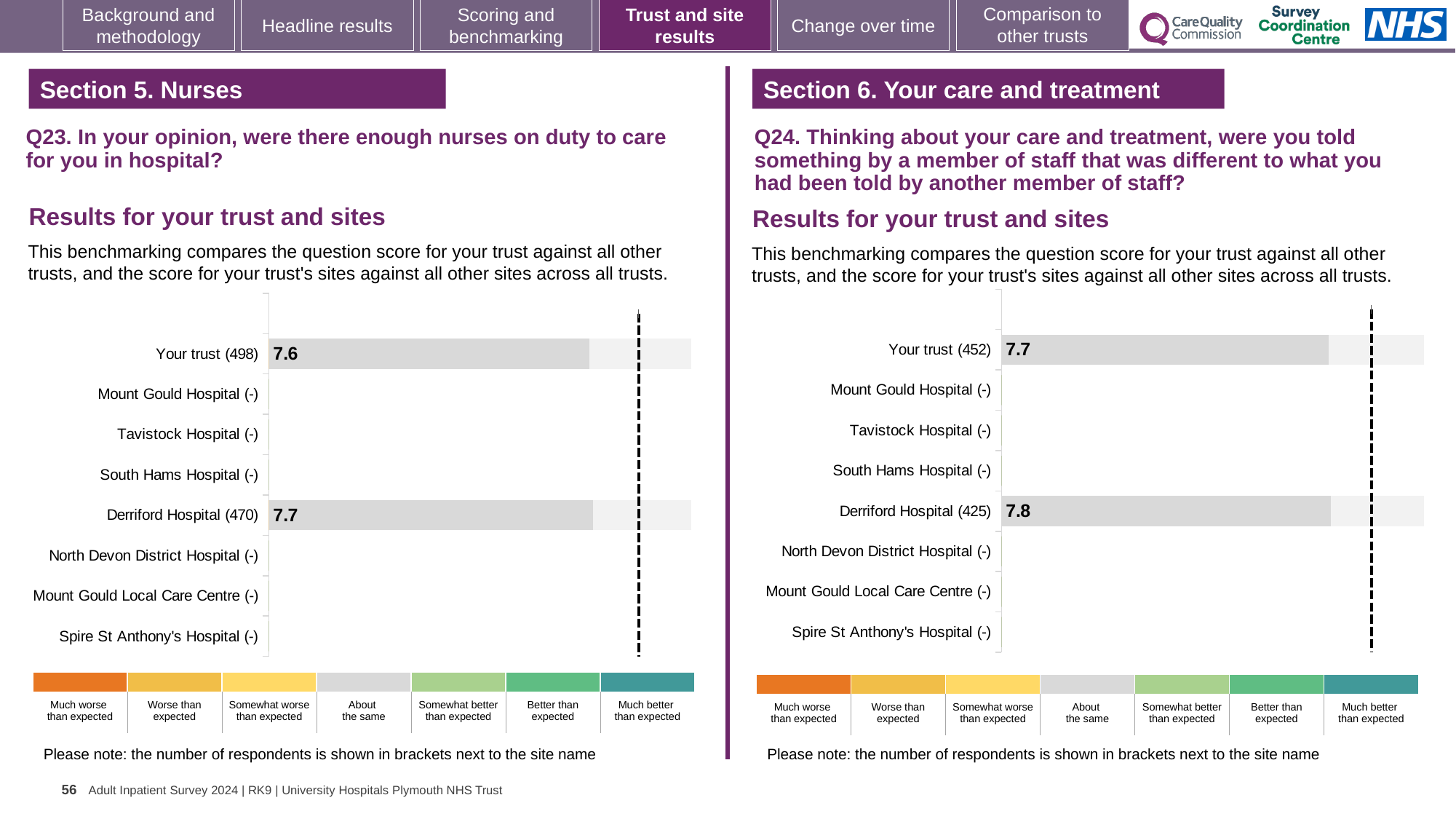
In the Q24 chart on the right, what is the score for Your trust? 7.7 In the Q24 chart on the right, how many respondents are shown in brackets for Your trust? 452 In the Q23 chart on the left, how many respondents are shown in brackets for Derriford Hospital? 470 In the Q23 chart on the left, which has the higher score: Your trust or Derriford Hospital? Derriford Hospital In the Q23 chart on the left, what is the difference between the Derriford Hospital score and the Your trust score? 0.1 In the Q23 chart on the left, what is the score for Derriford Hospital? 7.7 In the Q23 chart on the left, what is the score for Your trust? 7.6 What kind of chart is used for the Q24 results on the right? Bar chart In the Q24 chart on the right, what is the difference between the Derriford Hospital score and the Your trust score? 0.1 In the Q24 chart on the right, which has the higher score: Your trust or Derriford Hospital? Derriford Hospital How many categories are listed on the y axis of the Q23 chart on the left? 8 In the Q24 chart on the right, what is the score for Derriford Hospital? 7.8